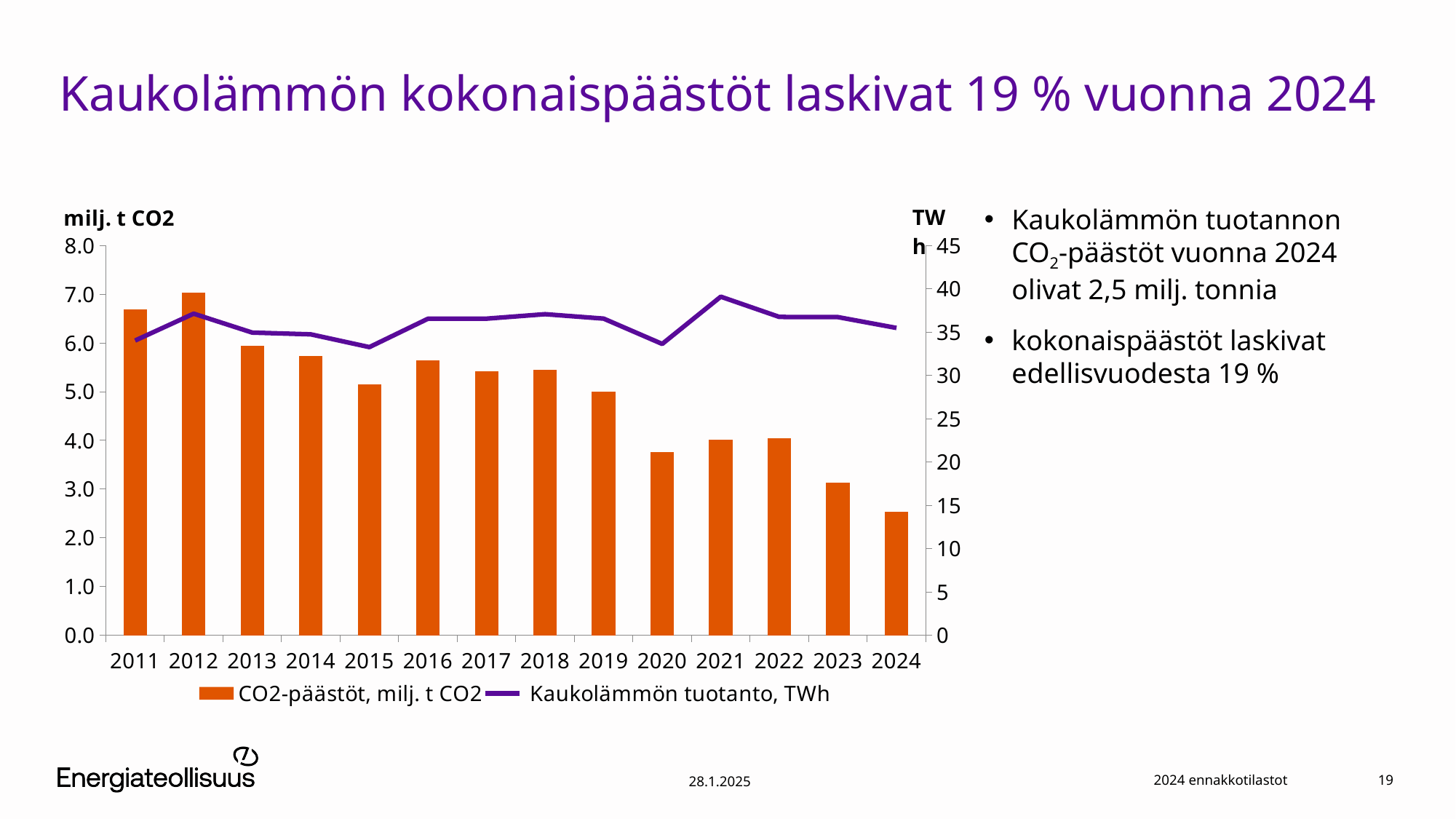
Which year has the highest bar for CO2-päästöt, milj. t CO2? 2012 Is the CO2-päästöt value for 2020 greater or less than 4.0? less Is the CO2-päästöt value for 2024 greater or less than 3.0? less Which year has the larger CO2-päästöt bar, 2011 or 2024? 2011 Which year has the lowest bar for CO2-päästöt, milj. t CO2? 2024 Is the Kaukolämmön tuotanto, TWh value for 2021 greater or less than 35? greater In which year does the Kaukolämmön tuotanto, TWh line reach its highest point? 2021 How many series does the legend list? 2 Do the CO2-päästöt bars generally rise or fall from 2011 to 2024? fall How many years are shown on the x axis? 14 What kind of chart is shown on the slide? A combined bar and line chart